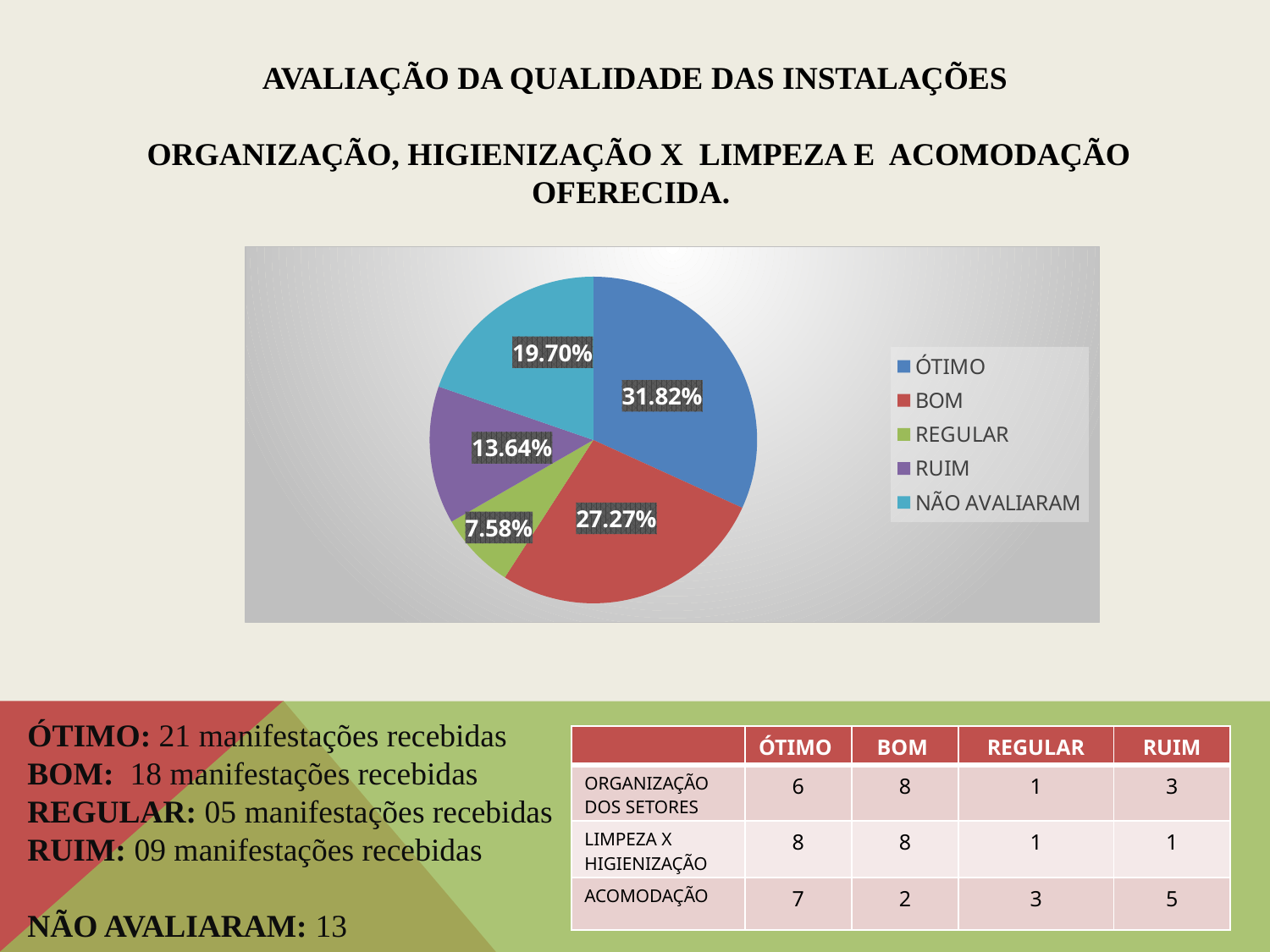
What kind of chart is shown on the slide? pie chart What is the value shown for RUIM in the pie chart? 13.64% What share of the pie does ÓTIMO represent? 31.82% What share of the pie does BOM represent? 27.27% Which category has the largest slice of the pie? ÓTIMO Which category has the smallest slice of the pie? REGULAR How many entries does the legend of the pie chart list? 5 What is the difference in percentage points between the ÓTIMO and BOM slices? 4.55% Which slice is larger, NÃO AVALIARAM or RUIM? NÃO AVALIARAM What is the value shown for NÃO AVALIARAM in the pie chart? 19.70% What is the value shown for REGULAR in the pie chart? 7.58% How many slices does the pie chart have? 5